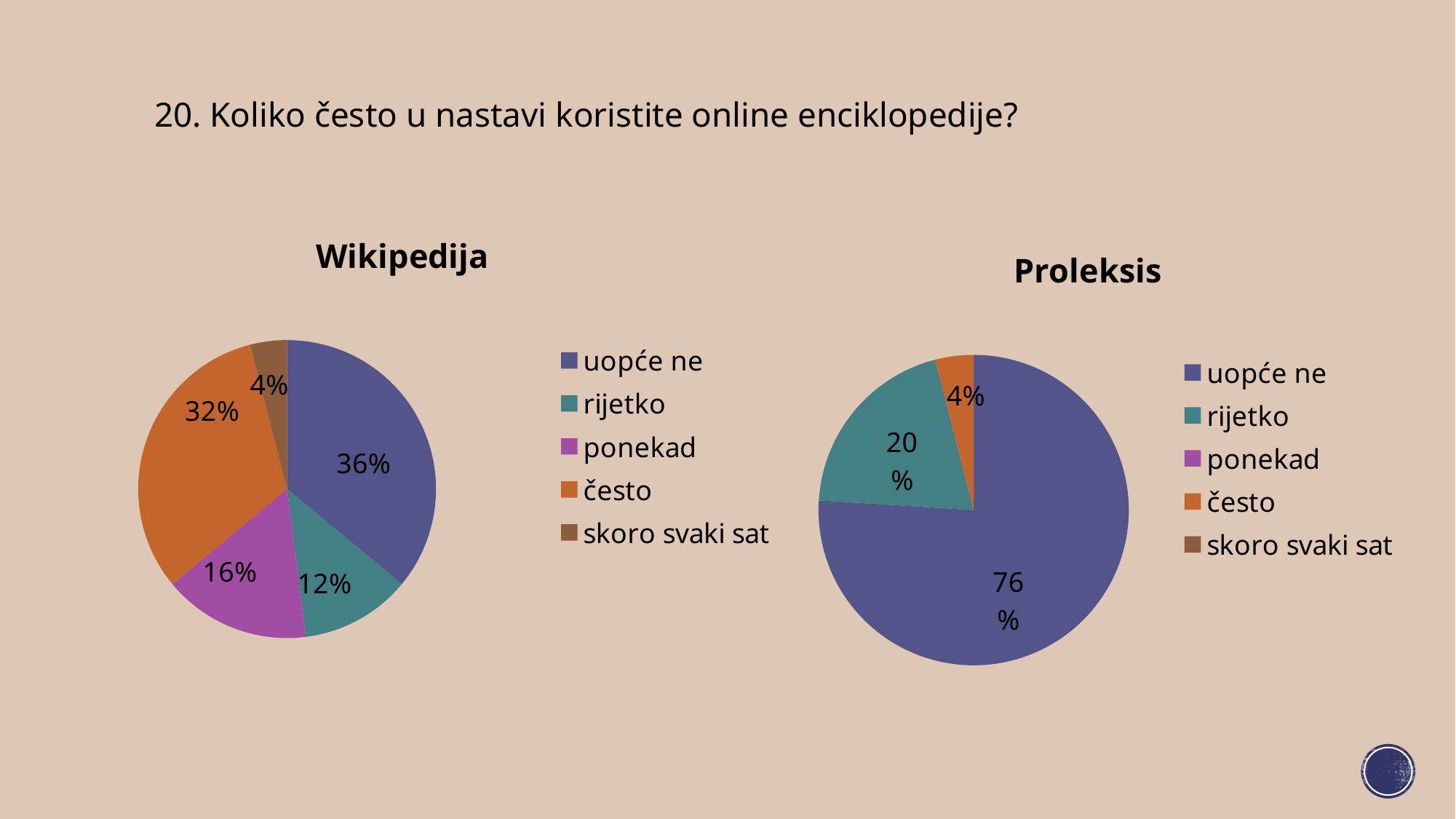
In the Wikipedija chart, which is larger: "ponekad" or "rijetko"? ponekad In the Wikipedija chart, which category has the smallest slice? skoro svaki sat In the Proleksis chart, what percentage is shown for "rijetko"? 20% In the Wikipedija chart, what percentage is shown for "ponekad"? 16% In the Proleksis chart, what share of respondents answered "uopće ne"? 76% How many entries does the legend of the Proleksis chart list? 5 What type of chart is used for Wikipedija? Pie chart In the Wikipedija chart, which category has the largest slice? uopće ne In the Proleksis chart, which category has the smallest labelled slice? često In the Wikipedija chart, what percentage is shown for "često"? 32% In the Wikipedija chart, what share of respondents answered "uopće ne"? 36% In the Wikipedija chart, what is the difference between the "uopće ne" and "rijetko" shares? 24%